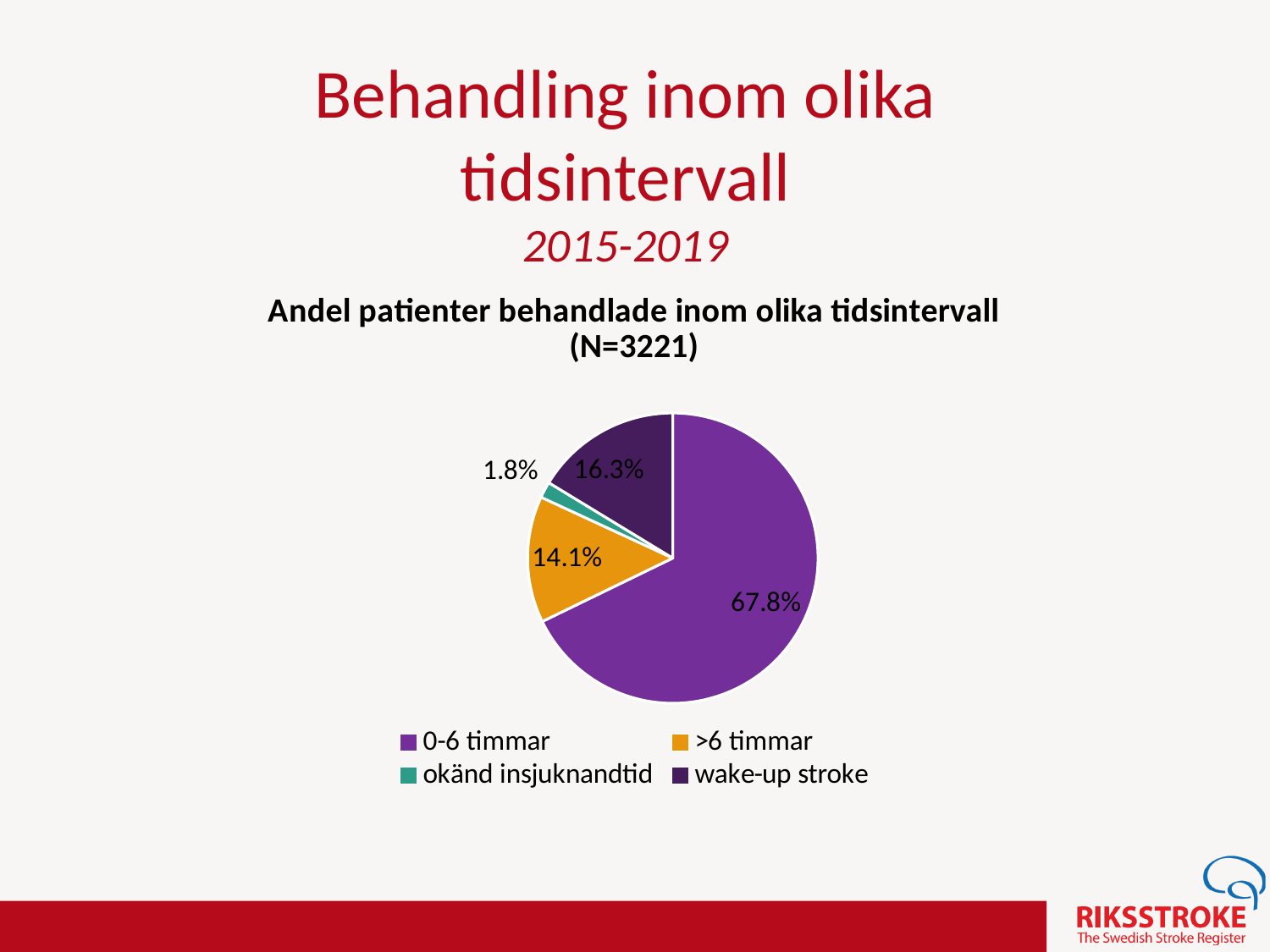
Which category has the smallest slice of the pie? okänd insjuknandtid How many categories does the pie chart show? 4 What share of patients had okänd insjuknandtid? 1.8% What share of patients had a wake-up stroke? 16.3% Which colour represents the >6 timmar category in the legend? orange Which category has the largest slice of the pie? 0-6 timmar What is the N value given in the chart title? 3221 Which is larger, the wake-up stroke slice or the >6 timmar slice? wake-up stroke What is the difference in percentage points between the 0-6 timmar slice and the >6 timmar slice? 53.7 What kind of chart is shown on the slide? pie chart What share of patients were treated after >6 timmar? 14.1% What share of patients were treated within 0-6 timmar? 67.8%